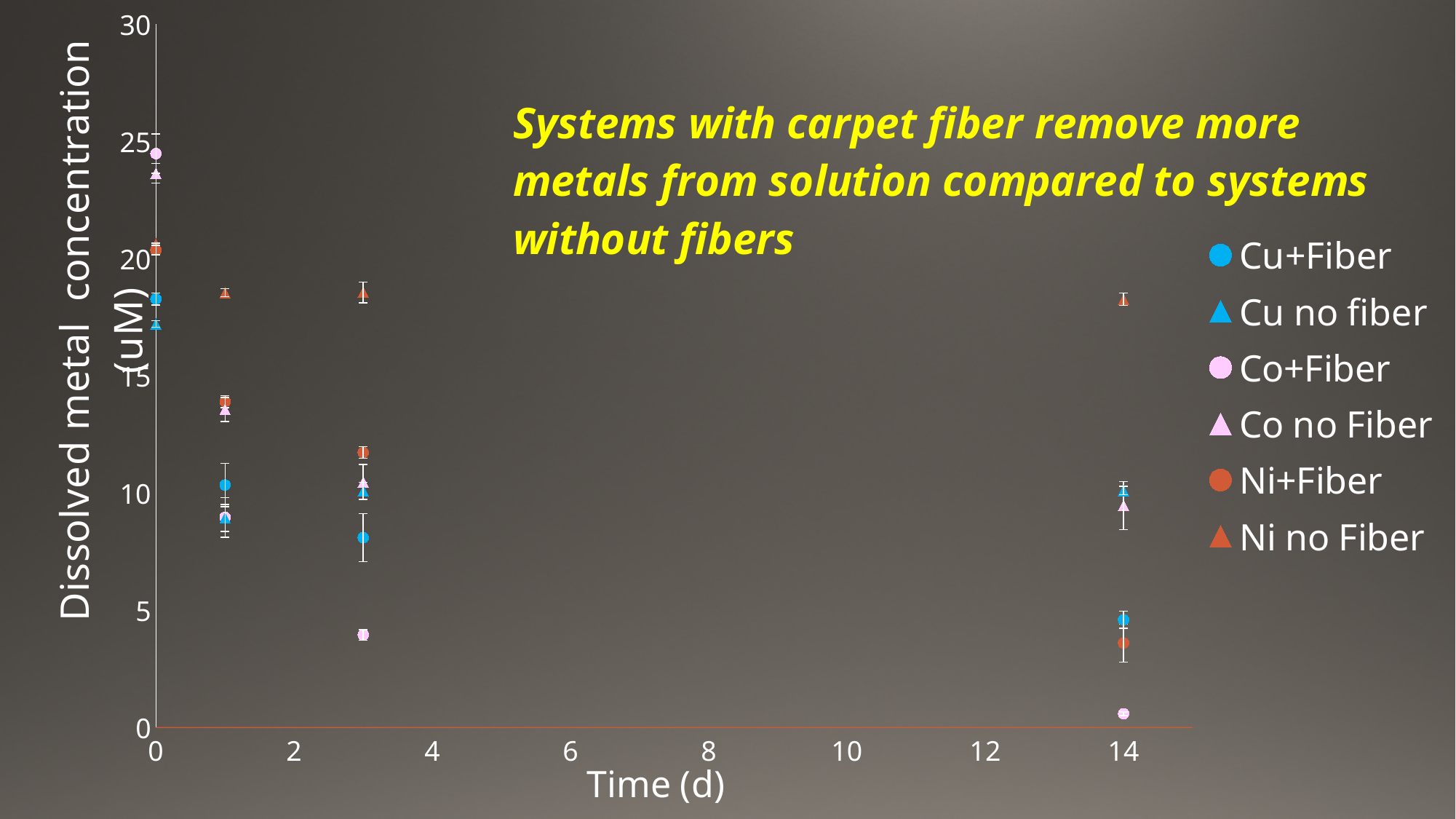
At how many time points are measurements plotted? 4 How many series does the legend list? 6 What kind of chart is shown on the slide? Scatter chart Which series has the highest dissolved metal concentration at day 14? Ni no Fiber At day 14, which is larger: the value for Cu no fiber or the value for Cu+Fiber? Cu no fiber Is the value for Ni no Fiber at day 14 greater or less than 15? greater Which series has the lowest dissolved metal concentration at day 14? Co+Fiber Is the value for Co+Fiber at day 0 greater or less than 20? greater What is the title of the y axis? Dissolved metal concentration (uM) Is the value for Cu+Fiber at day 3 greater or less than 10? less What is the title of the x axis? Time (d)